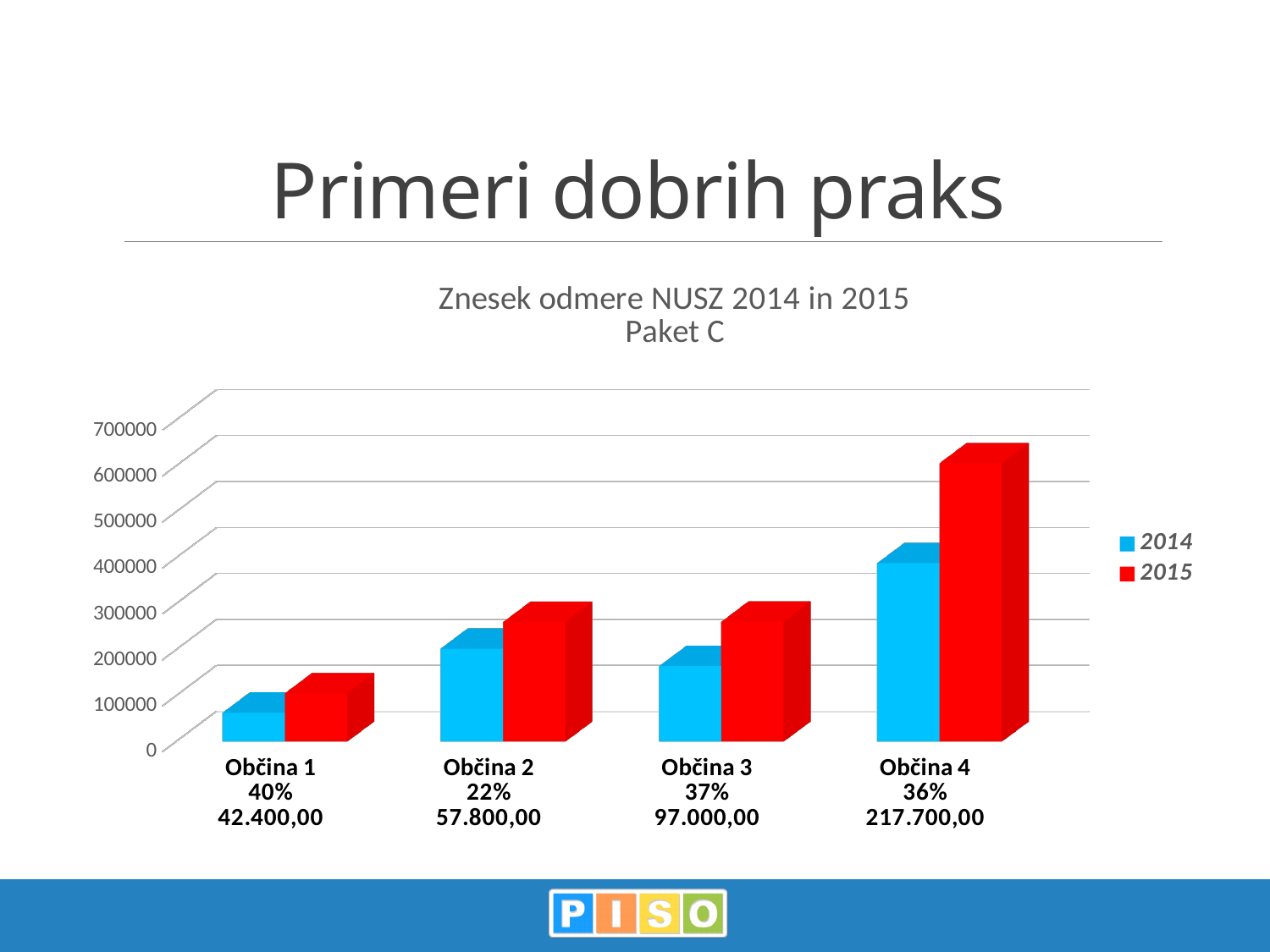
How many municipalities (categories) are shown on the x axis? 4 Which colour represents the 2015 series in the legend? red Is the 2015 value for Občina 4 greater or less than 500000? greater Which municipality has the lowest value for 2014? Občina 1 What percentage is printed under the label Občina 3? 37% For Občina 4, which is larger, the 2014 value or the 2015 value? 2015 Is the 2014 value for Občina 4 greater or less than 300000? greater What kind of chart is shown on the slide? bar chart How many series does the legend list? 2 Which municipality has the highest value for 2015? Občina 4 Is the 2014 value for Občina 1 greater or less than 100000? less